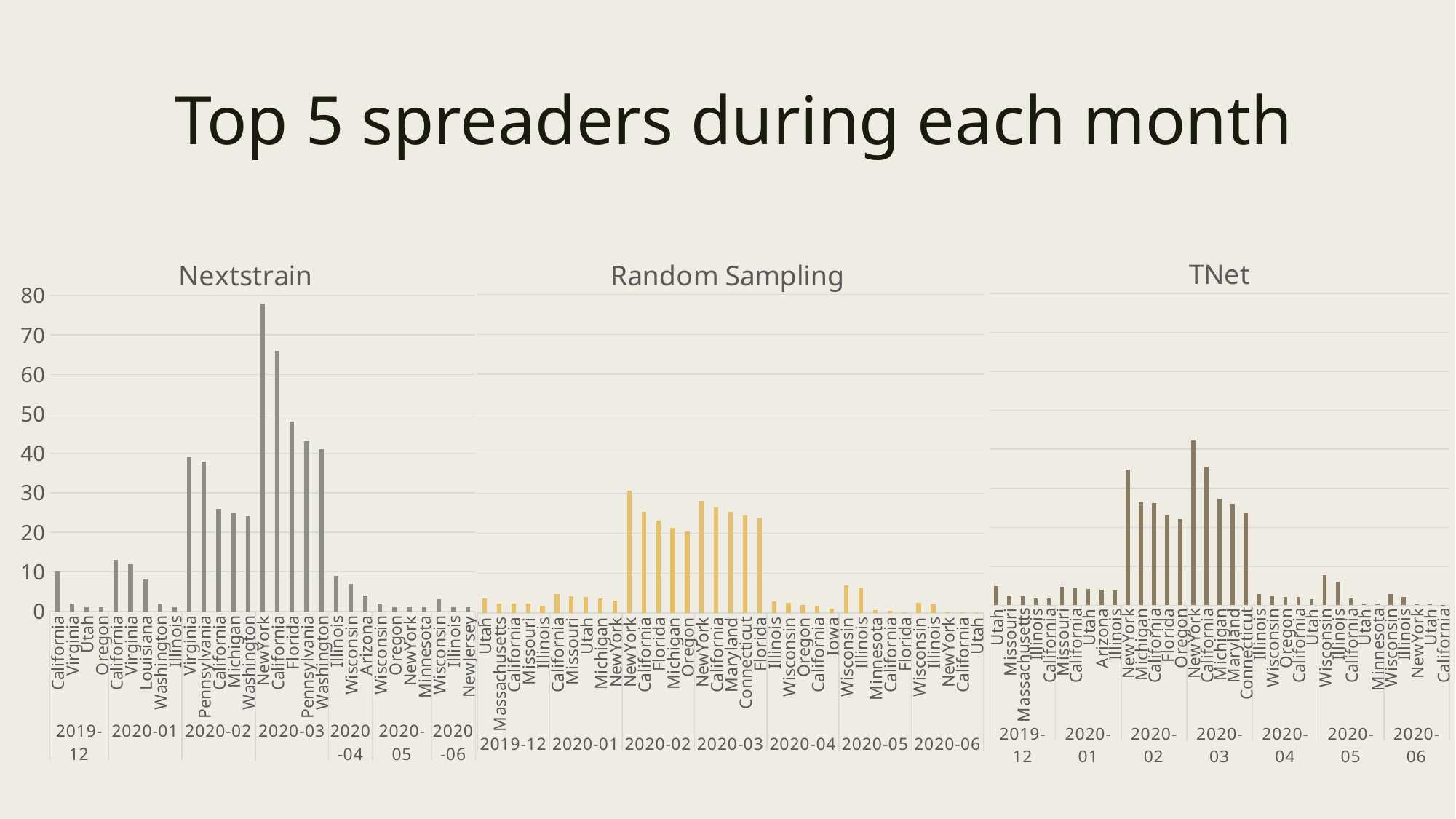
In the Nextstrain chart, is the value for New York in 2020-03 greater or less than 70? greater In the TNet chart, which is larger in 2020-03: New York or Michigan? New York In the Random Sampling chart, which state has the tallest bar? New York What kind of chart is the Nextstrain chart? bar chart In the Nextstrain chart, is the value for California in 2020-03 greater or less than 60? greater In the Random Sampling chart, is the value for New York in 2020-03 greater or less than 20? greater In the Nextstrain chart, which is larger in 2020-03: New York or Florida? New York How many month groups are shown on the x axis of the Random Sampling chart? 7 In the Nextstrain chart, which state has the tallest bar? New York In the TNet chart, which state has the tallest bar? New York